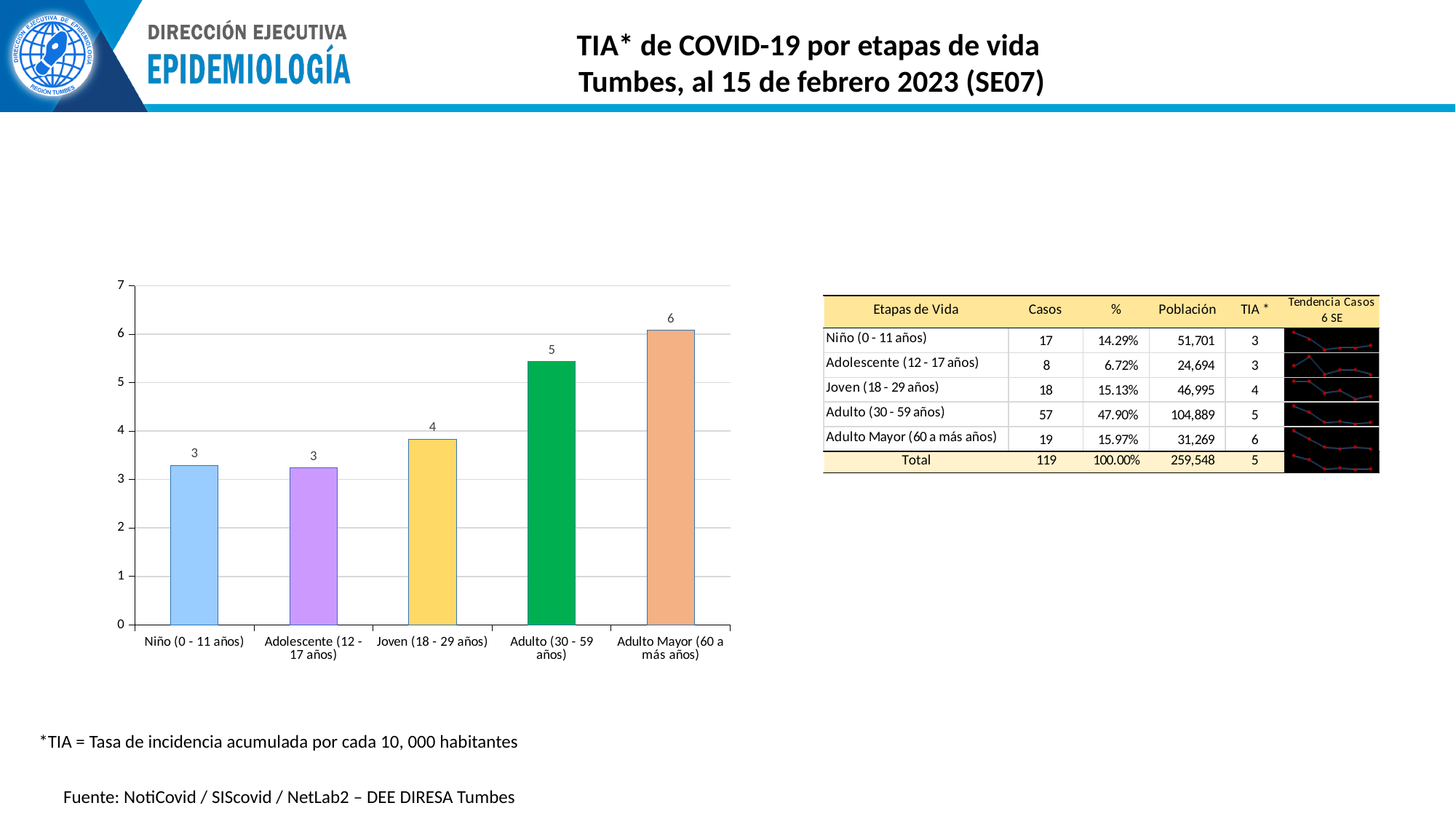
What is the TIA value shown for Adulto (30 - 59 años)? 5 Do the TIA values rise or fall moving from left to right across the life stages? rise What is the difference between the TIA values for Adulto Mayor (60 a más años) and Niño (0 - 11 años)? 3 What is the TIA value shown for Niño (0 - 11 años)? 3 Which has a larger TIA value, Adulto (30 - 59 años) or Joven (18 - 29 años)? Adulto (30 - 59 años) Is the value for Adulto Mayor (60 a más años) greater or less than 5? greater How many life-stage categories are plotted in the bar chart? 5 What colour is the bar for Adulto (30 - 59 años)? green Which life stage has the highest TIA value in the chart? Adulto Mayor (60 a más años) What is the TIA value shown for Adulto Mayor (60 a más años)? 6 What type of chart is shown on the slide? bar chart What is the TIA value shown for Joven (18 - 29 años)? 4